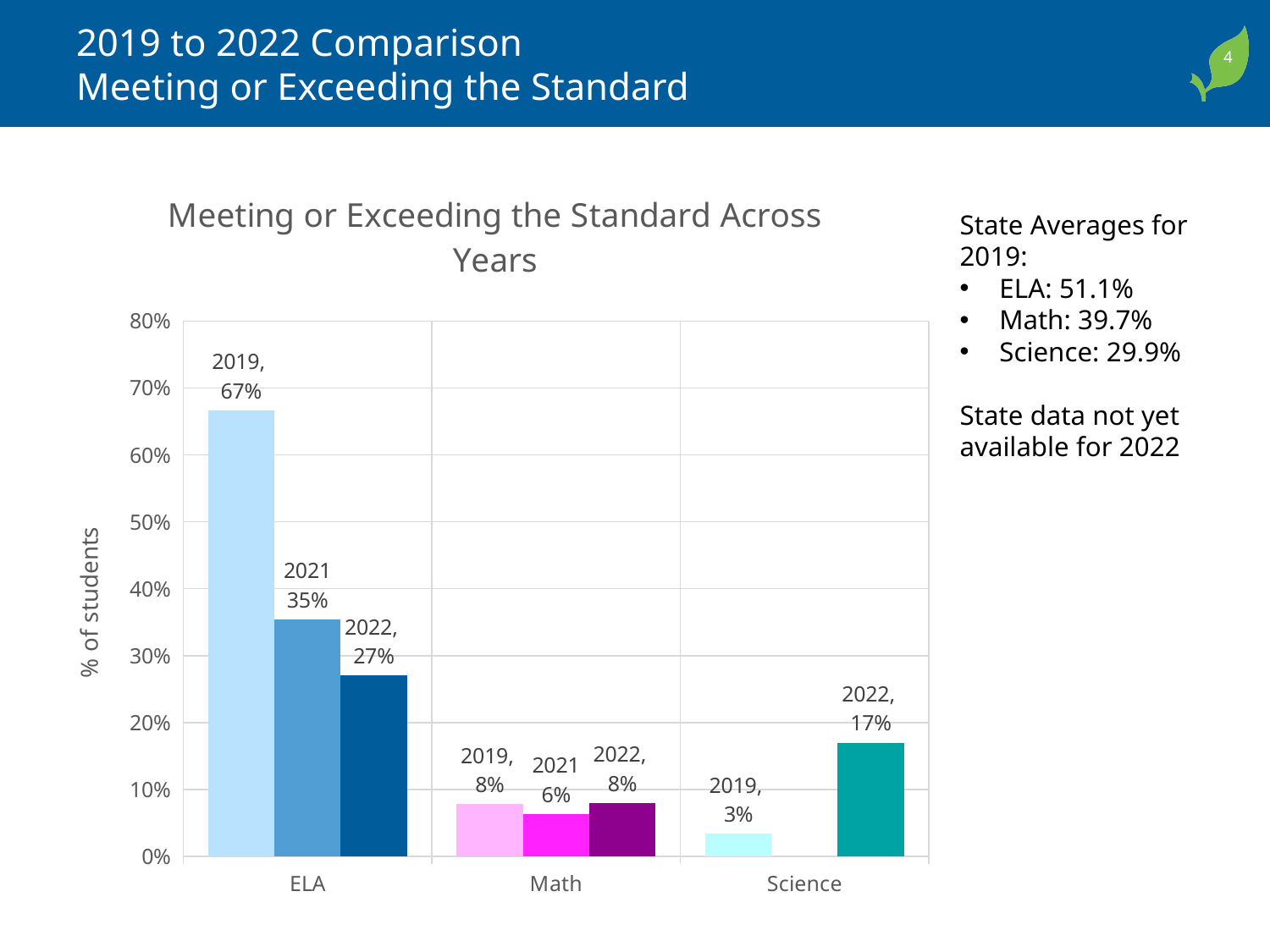
What is the value for ELA in 2022? 27% What is the value for Science in 2022? 17% Which subject has the highest 2019 value? ELA Do the ELA values rise or fall from 2019 to 2022? Fall What is the difference between the Science values for 2022 and 2019? 14% How many subject categories are shown on the x axis? 3 What percentage of students met or exceeded the standard in ELA in 2019? 67% What is the value for Math in 2021? 6% Which subject has the lowest 2019 value? Science What kind of chart is shown on the slide? Bar chart What is the difference between the ELA values for 2019 and 2022? 40% Which is larger, the 2021 value for ELA or the 2022 value for Science? 2021 value for ELA